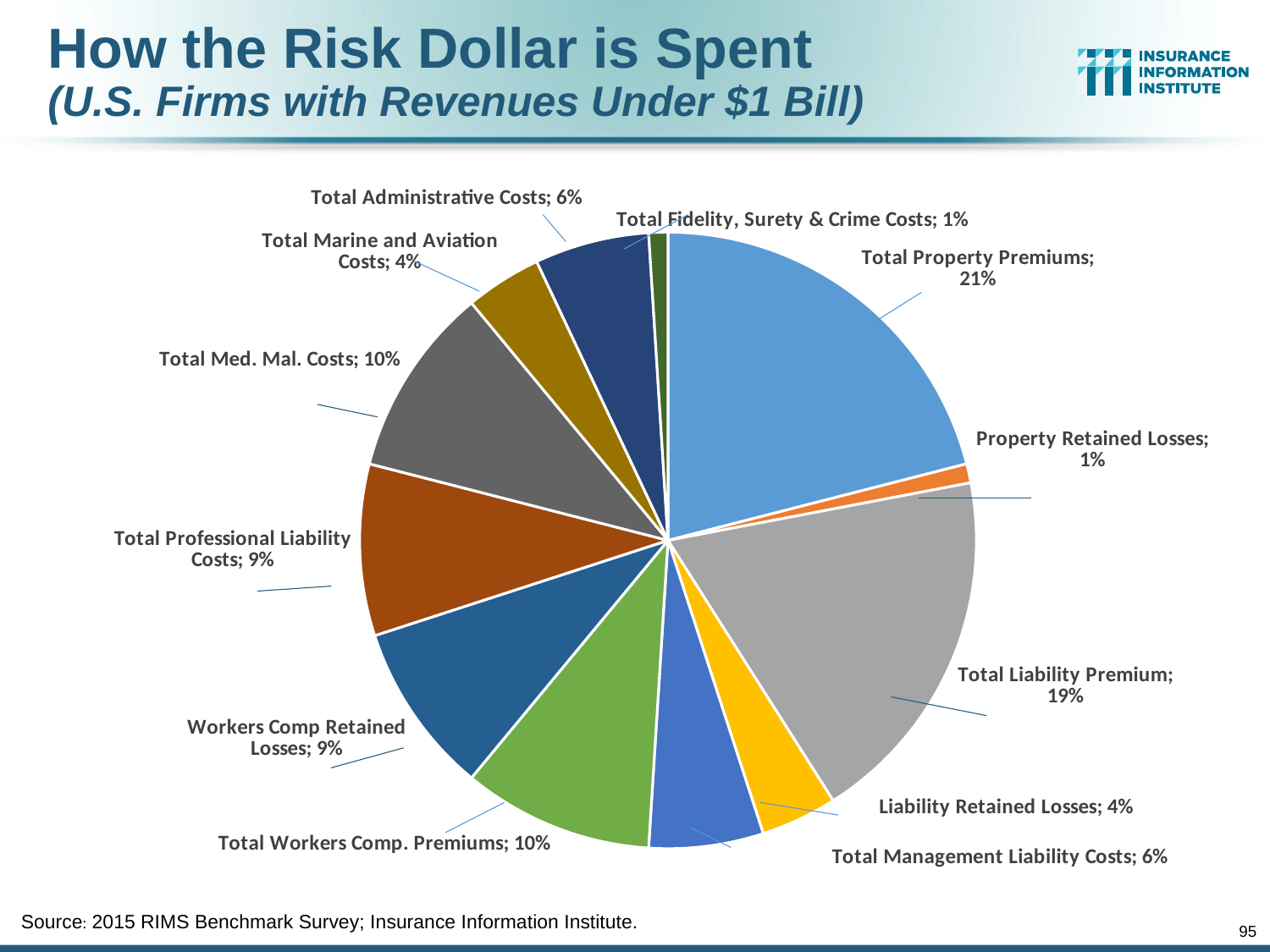
What is the combined share of Total Administrative Costs and Total Management Liability Costs? 12% Which is larger, Total Workers Comp. Premiums or Workers Comp Retained Losses? Total Workers Comp. Premiums What share of the risk dollar goes to Total Property Premiums? 21% What kind of chart is shown on the slide? Pie chart Which category has the largest share of the pie? Total Property Premiums What is the value for Total Med. Mal. Costs? 10% What percentage is labeled for Total Marine and Aviation Costs? 4% How many slices does the pie chart have? 12 What is the difference in percentage points between Total Property Premiums and Total Liability Premium? 2 What percentage is shown for Total Liability Premium? 19% What is the title of the slide containing the chart? How the Risk Dollar is Spent (U.S. Firms with Revenues Under $1 Bill) What share is shown for Total Fidelity, Surety & Crime Costs? 1%